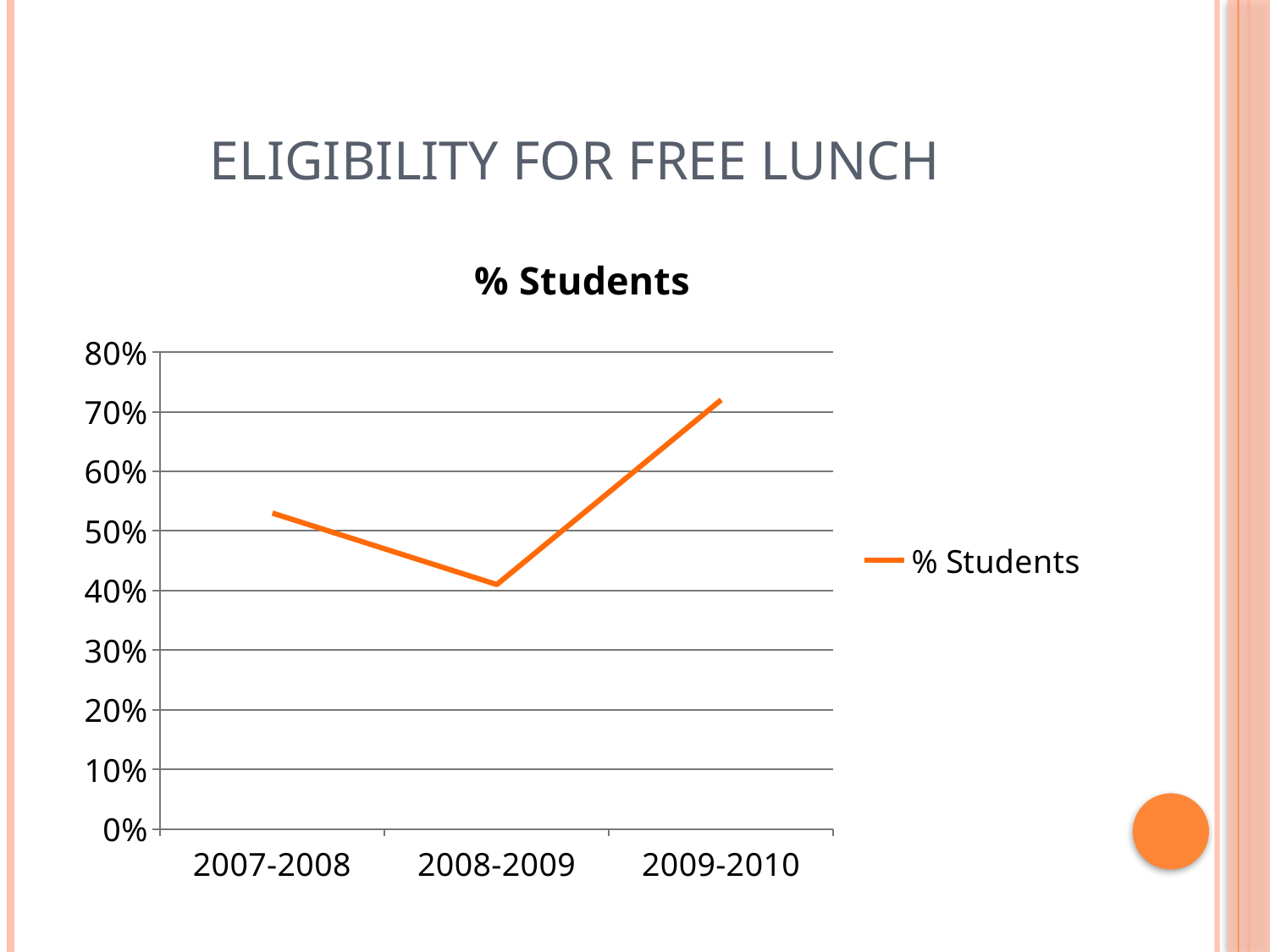
Which is larger, the value for 2007-2008 or the value for 2008-2009? 2007-2008 How many school years are plotted on the x axis? 3 What type of chart is shown on the slide? line chart How many series does the legend list? 1 Which school year has the highest % Students value? 2009-2010 What is the title of the chart? % Students Is the value for 2008-2009 greater or less than 50%? less Is the value for 2009-2010 greater or less than 60%? greater What colour is the % Students line? orange Is the value for 2007-2008 greater or less than 50%? greater Does the % Students value rise or fall from 2008-2009 to 2009-2010? rise Which school year has the lowest % Students value? 2008-2009